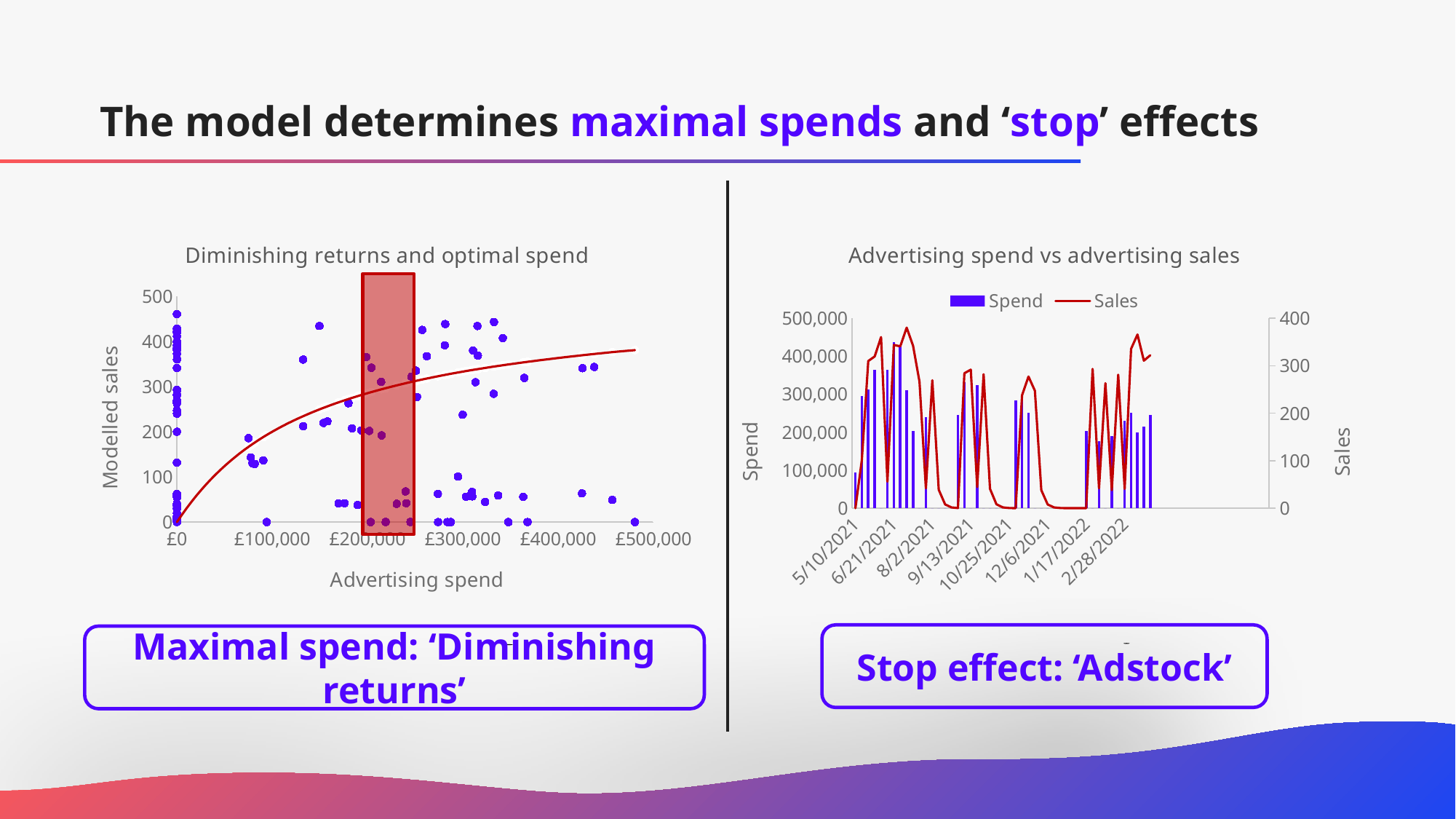
What is the x-axis label of the left chart 'Diminishing returns and optimal spend'? Advertising spend In the left chart 'Diminishing returns and optimal spend', does the fitted curve rise or fall as advertising spend increases? rise How many series does the legend of the right chart 'Advertising spend vs advertising sales' list? 2 What is the maximum value shown on the right-hand Sales axis of the right chart 'Advertising spend vs advertising sales'? 400 What kind of chart is the right chart titled 'Advertising spend vs advertising sales'? combined bar and line chart In the left chart 'Diminishing returns and optimal spend', is the fitted curve's value at £100,000 greater or less than 300? less In the right chart 'Advertising spend vs advertising sales', which series is drawn as bars? Spend In the right chart 'Advertising spend vs advertising sales', is the peak of the Sales line greater or less than 300? greater What kind of chart is the left chart titled 'Diminishing returns and optimal spend'? scatter chart with a fitted curve How many date labels are shown on the x axis of the right chart 'Advertising spend vs advertising sales'? 8 In the right chart 'Advertising spend vs advertising sales', is the tallest Spend bar greater or less than 400,000? greater